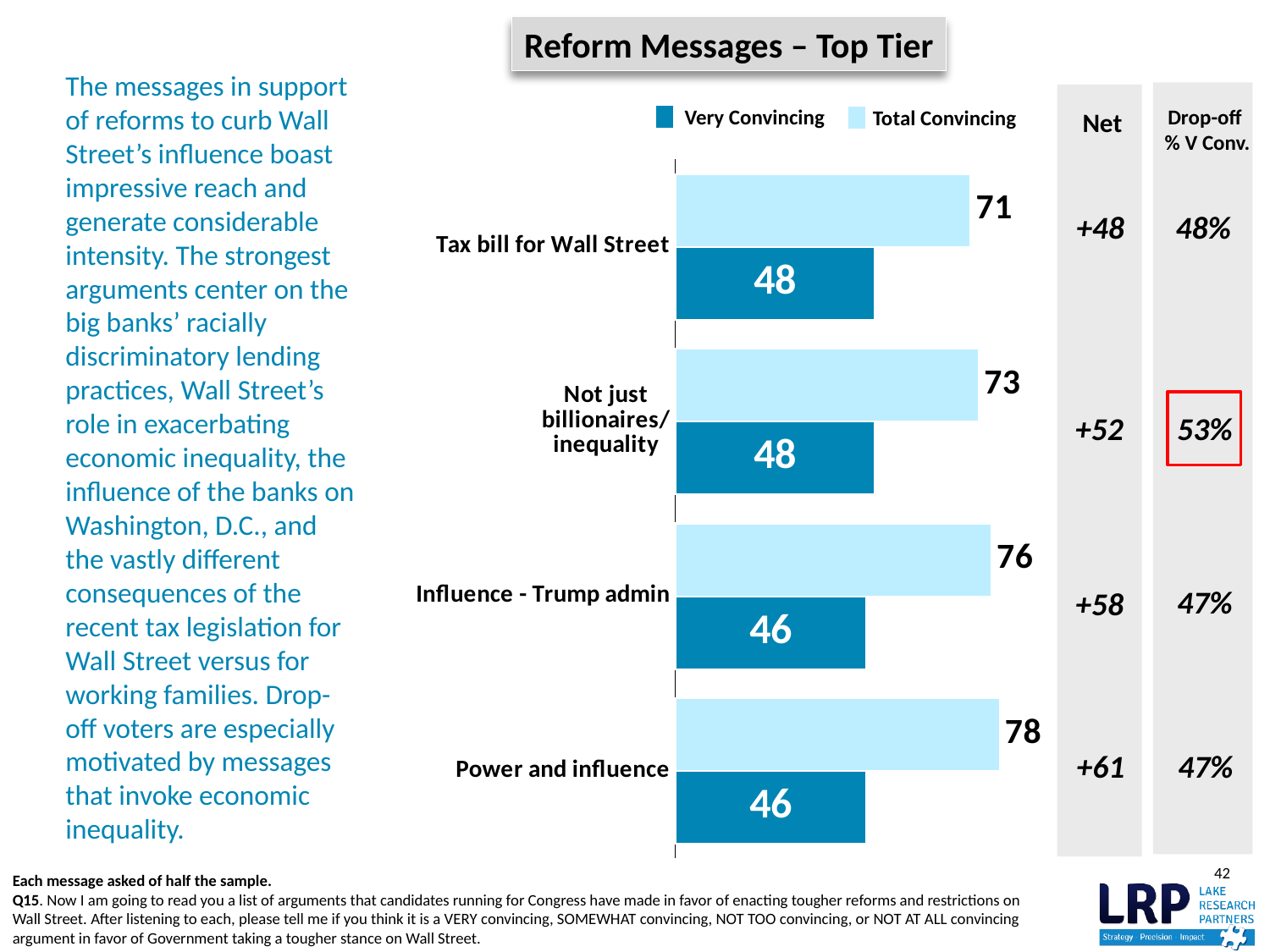
Which category has the highest Total Convincing value? Power and influence Which category has the lowest Total Convincing value? Tax bill for Wall Street How many series does the legend list? 2 What is the Total Convincing value for Not just billionaires/inequality? 73 How many categories are shown in the chart? 4 What is the title of the chart? Reform Messages – Top Tier Which is larger, the Total Convincing value for Influence - Trump admin or for Not just billionaires/inequality? Influence - Trump admin What is the Very Convincing value for Influence - Trump admin? 46 Which series is shown in the darker blue colour? Very Convincing What is the difference between the Total Convincing and Very Convincing values for Power and influence? 32 What kind of chart is shown on the slide? Bar chart What is the Total Convincing value for Tax bill for Wall Street? 71